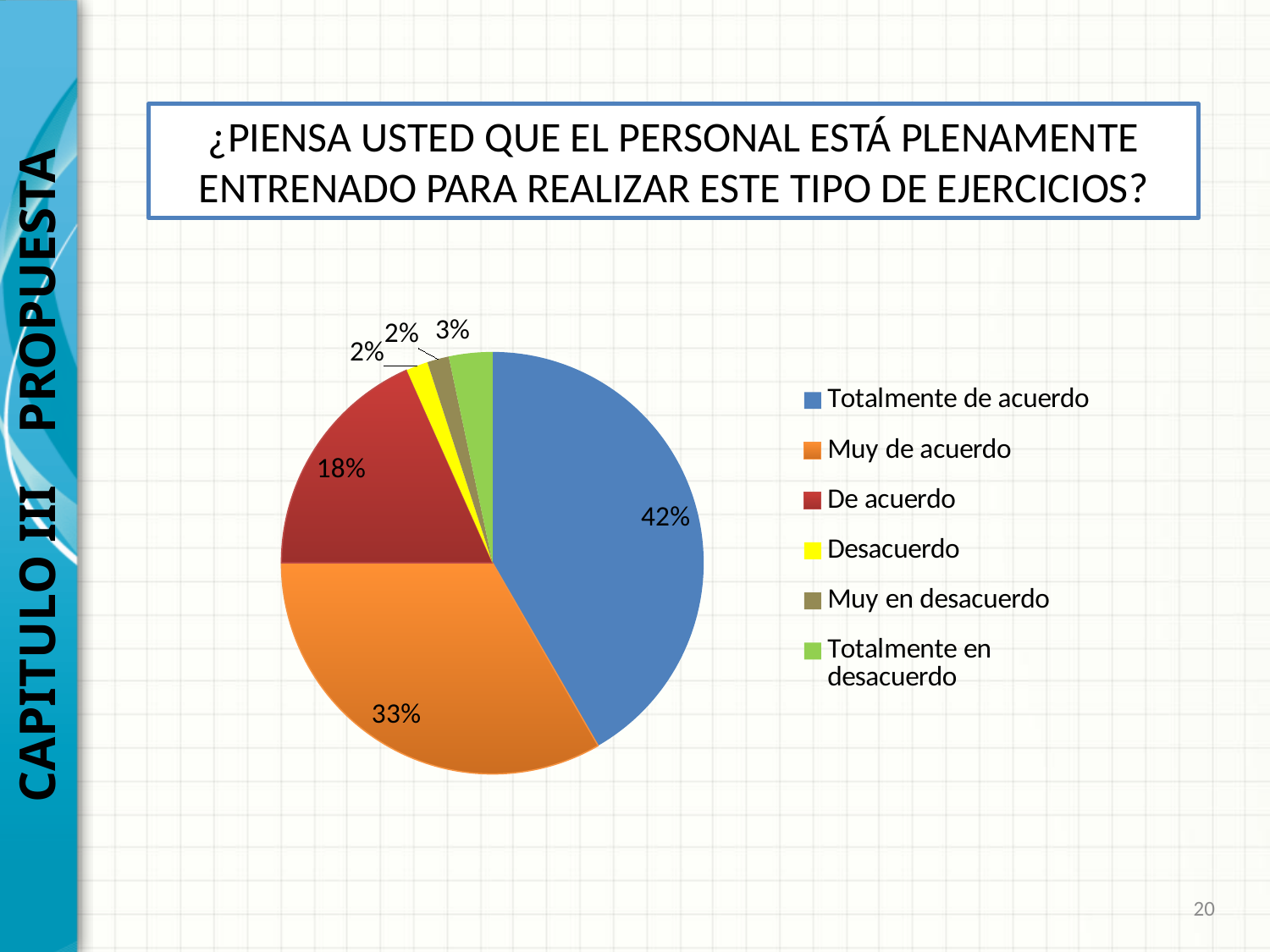
Which category has the largest slice of the pie? Totalmente de acuerdo Which is larger, the share for "De acuerdo" or the share for "Totalmente en desacuerdo"? De acuerdo What share of the pie does "Totalmente en desacuerdo" represent? 3% What share of the pie does "Desacuerdo" represent? 2% How many categories does the legend list? 6 What type of chart is shown on the slide? Pie chart What colour is the slice for "Desacuerdo"? Yellow What share of the pie does "Totalmente de acuerdo" represent? 42% What is the difference between the shares for "Totalmente de acuerdo" and "Muy de acuerdo"? 9% What is the combined share of "Totalmente de acuerdo" and "Muy de acuerdo"? 75%